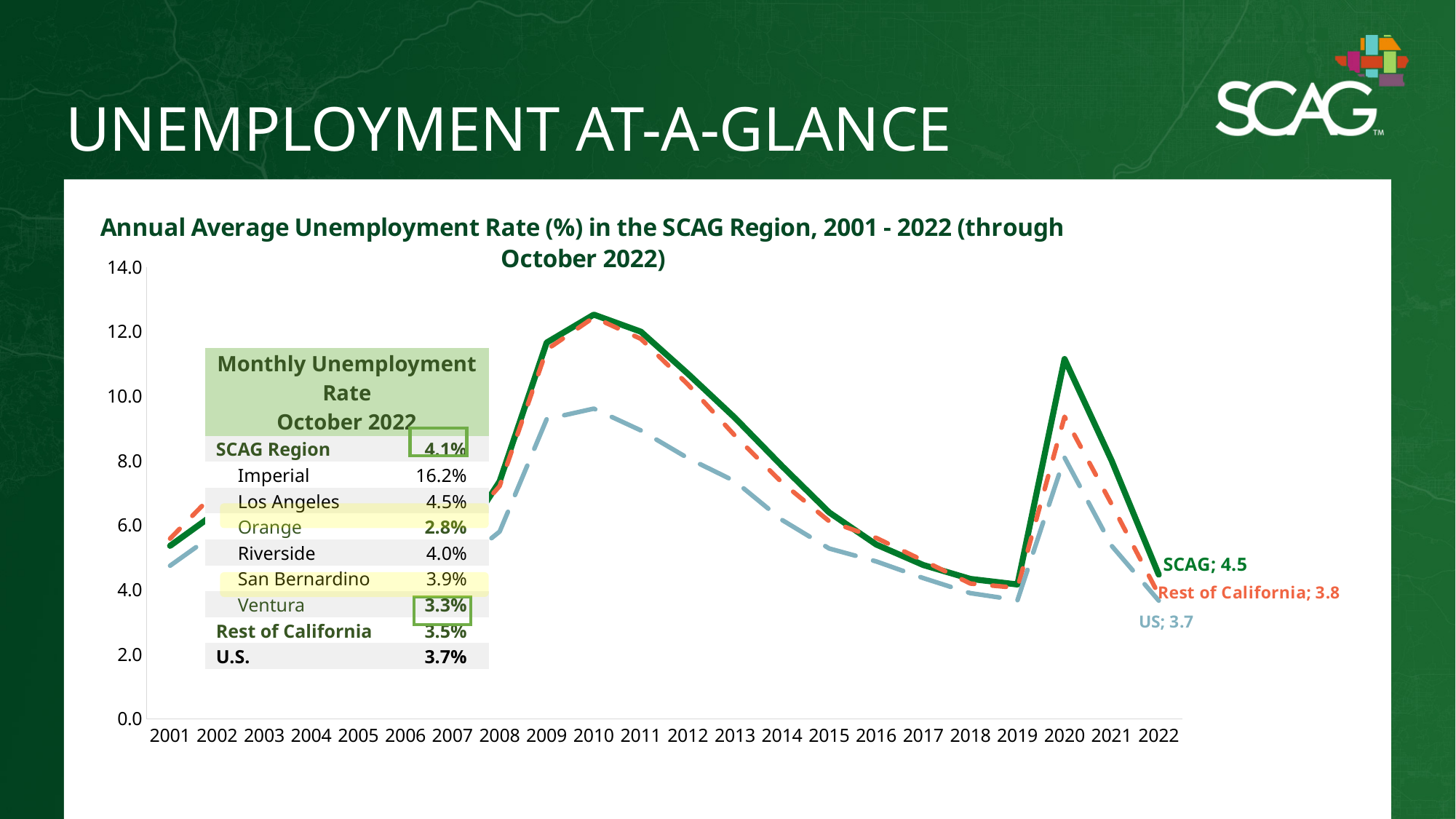
What is the Rest of California value labelled for 2022? 3.8 What is the SCAG unemployment rate value labelled for 2022? 4.5 What is the US value labelled for 2022? 3.7 In which year does the SCAG line reach its highest point? 2010 How many series are plotted on the chart? 3 Is the SCAG value for 2010 greater or less than 12.0? greater Between 2010 and 2019, does the SCAG line rise or fall? fall Is the SCAG value for 2020 greater or less than 10.0? greater In 2022, which is larger: the SCAG value or the US value? SCAG Is the US value for 2010 greater or less than 10.0? less What is the difference between the SCAG value and the US value in 2022? 0.8 What kind of chart is shown on the slide? line chart